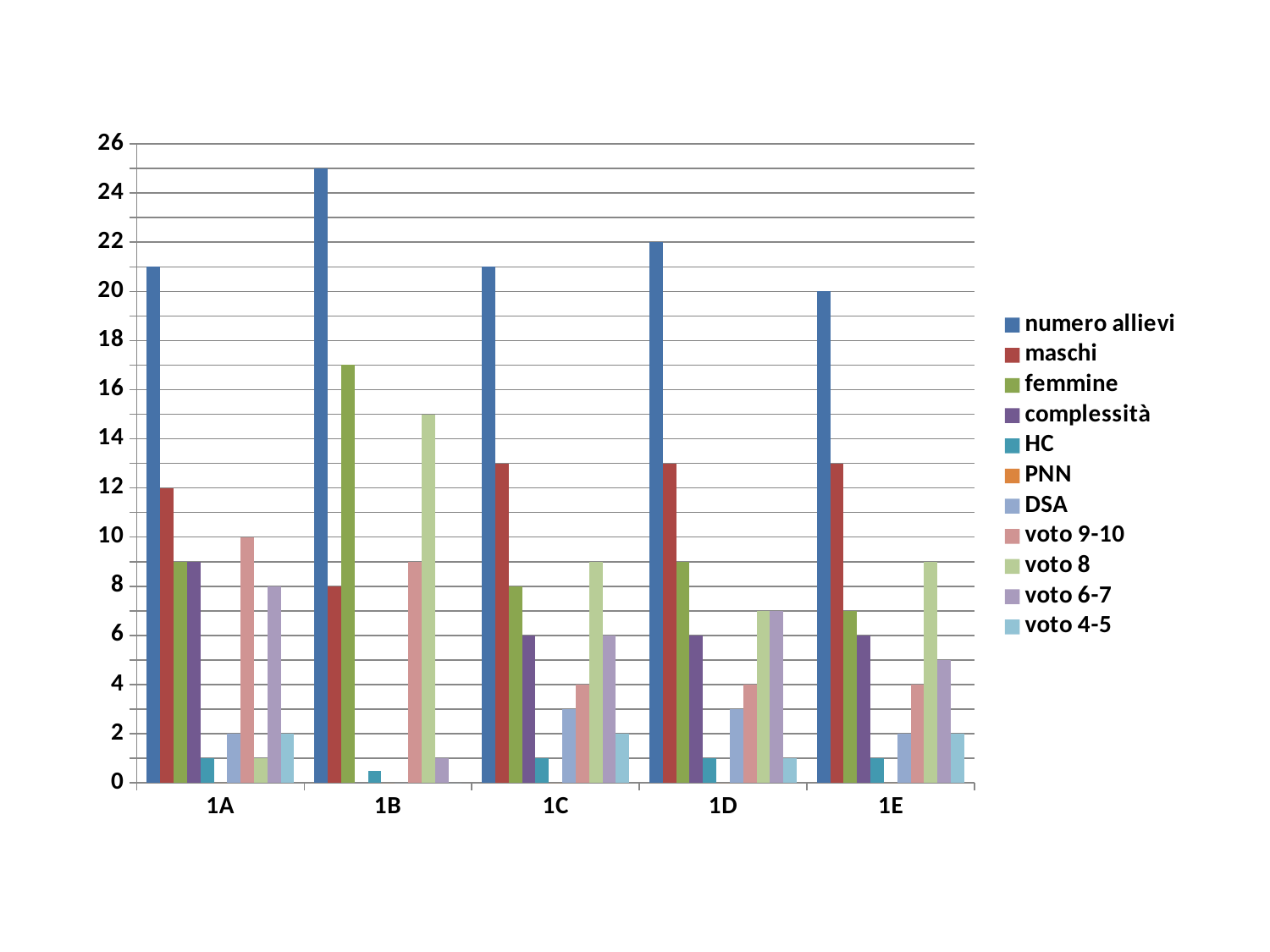
What is the difference between numero allievi for 1D and for 1E? 2 What is the value of voto 9-10 for class 1A? 10 Is the value of numero allievi for class 1B greater or less than 24? greater What kind of chart is shown on the slide? bar chart How many series does the legend list? 11 How many classes (categories) are shown on the x axis? 5 In class 1B, which is larger, maschi or femmine? femmine Which class has the highest value for numero allievi? 1B What is the value of numero allievi for class 1D? 22 What is the value of maschi for class 1A? 12 What is the value of numero allievi for class 1E? 20 Which class has the highest value for femmine? 1B